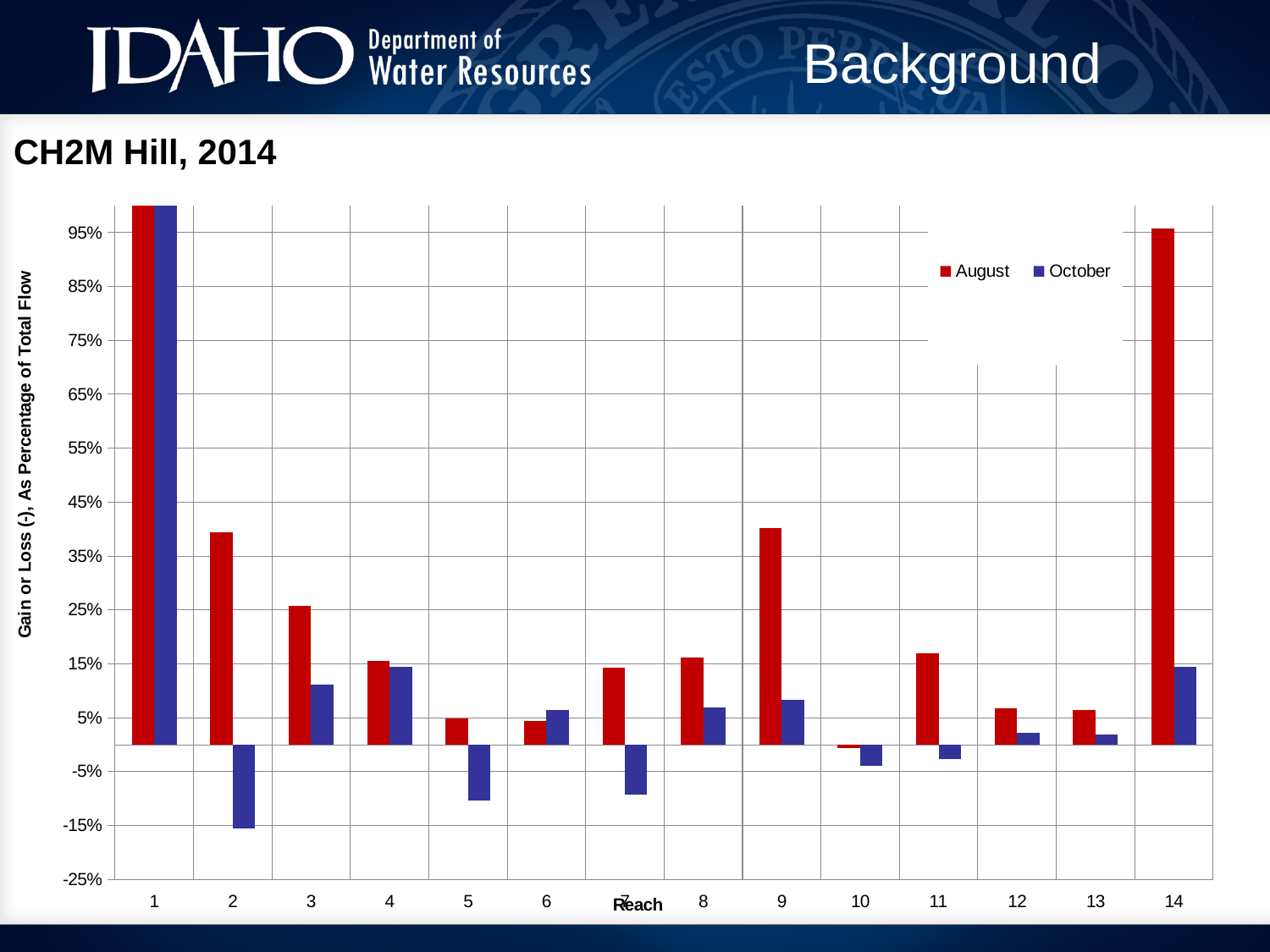
Is the August value for reach 14 greater or less than 85%? greater How many series does the legend list? 2 What kind of chart is shown on the slide? bar chart Is the October value for reach 5 greater or less than -5%? less Which reach has the highest October value? 1 Which is larger, the August value for reach 3 or the August value for reach 4? reach 3 How many reaches are shown along the x axis? 14 Which reach has the lowest August value? 10 Is the August value for reach 9 greater or less than 35%? greater For reach 2, which is larger, the August value or the October value? August Which reach has the lowest October value? 2 What are the two series named in the legend? August and October